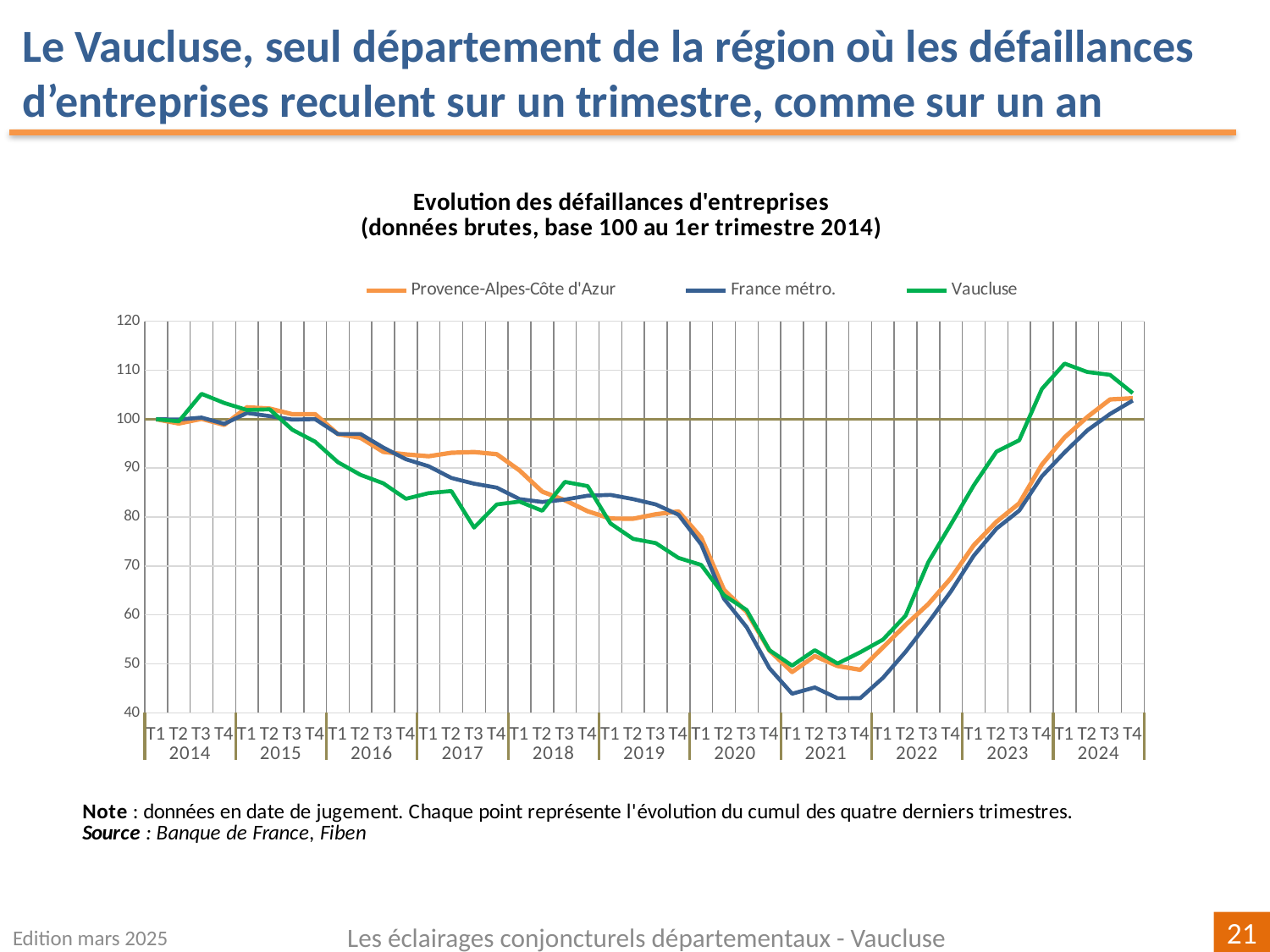
Between T1 2019 and T1 2021, does the France métro. line rise or fall? fall What is the title of the chart? Evolution des défaillances d'entreprises (données brutes, base 100 au 1er trimestre 2014) Is the value for Provence-Alpes-Côte d'Azur at T4 2022 greater or less than 80? less How many years are labelled along the x axis? 11 What is the value of the Vaucluse series at T1 2014? 100 At T3 2017, which is higher: Provence-Alpes-Côte d'Azur or Vaucluse? Provence-Alpes-Côte d'Azur Is the value for Vaucluse at T1 2024 greater or less than 100? greater Which series has the lowest value at T3 2021? France métro. Is the value for France métro. at T3 2021 greater or less than 50? less Which series has the highest value at T1 2024? Vaucluse What kind of chart is shown on the slide? line chart How many series does the legend list? 3